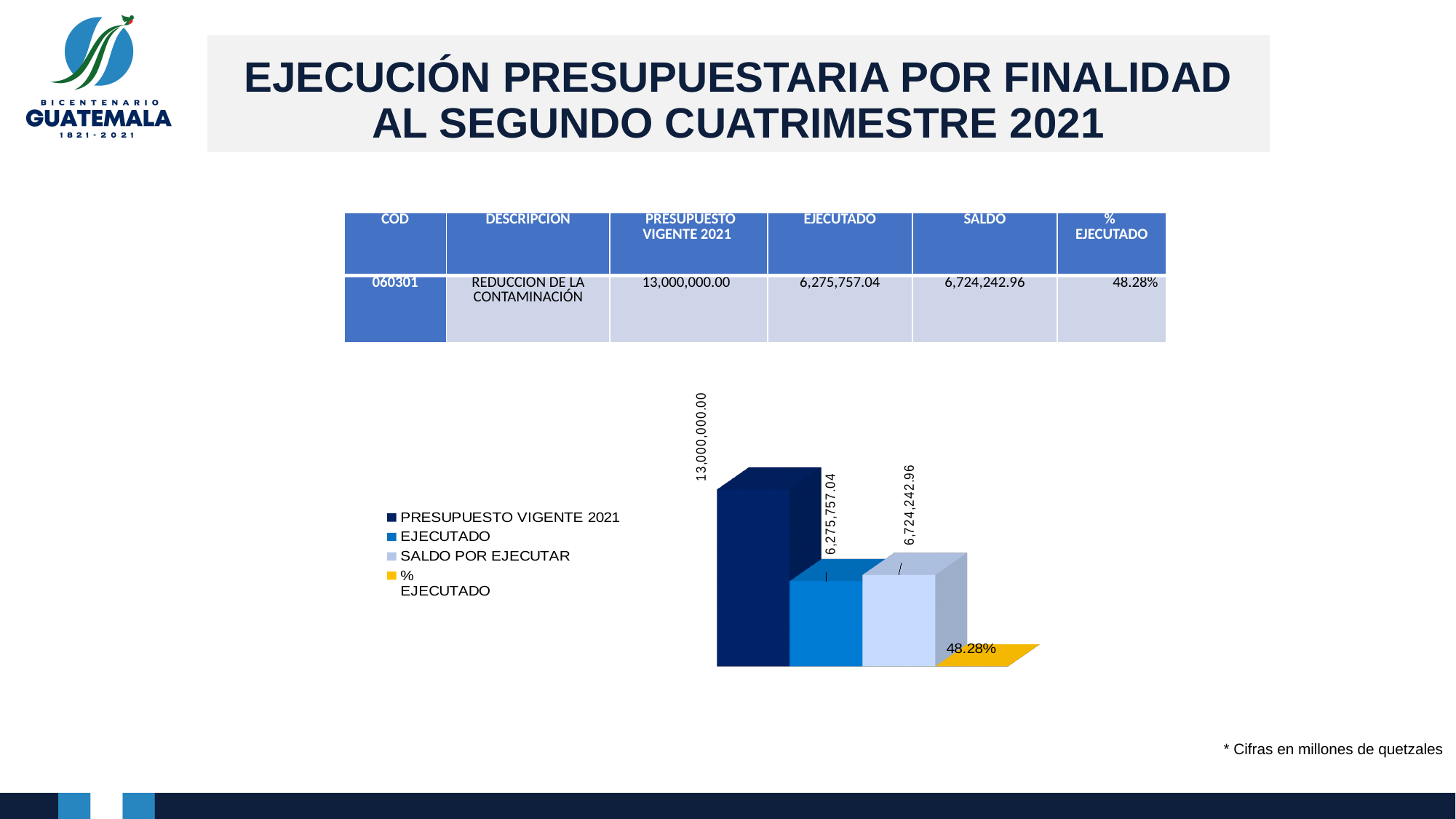
What colour is the PRESUPUESTO VIGENTE 2021 series in the chart legend? dark navy blue What colour is the % EJECUTADO series in the chart legend? yellow What is the difference between the SALDO POR EJECUTAR bar and the EJECUTADO bar? 448,485.92 Which series has the tallest bar in the chart? PRESUPUESTO VIGENTE 2021 Which is larger in the chart, EJECUTADO or SALDO POR EJECUTAR? SALDO POR EJECUTAR What is the difference between the PRESUPUESTO VIGENTE 2021 bar and the EJECUTADO bar? 6,724,242.96 What is the value of the SALDO POR EJECUTAR bar in the chart? 6,724,242.96 What kind of chart is shown on the slide? bar chart How many series does the chart legend list? 4 What is the value of the PRESUPUESTO VIGENTE 2021 bar in the chart? 13,000,000.00 What percentage is shown for % EJECUTADO in the chart? 48.28% What is the value of the EJECUTADO bar in the chart? 6,275,757.04